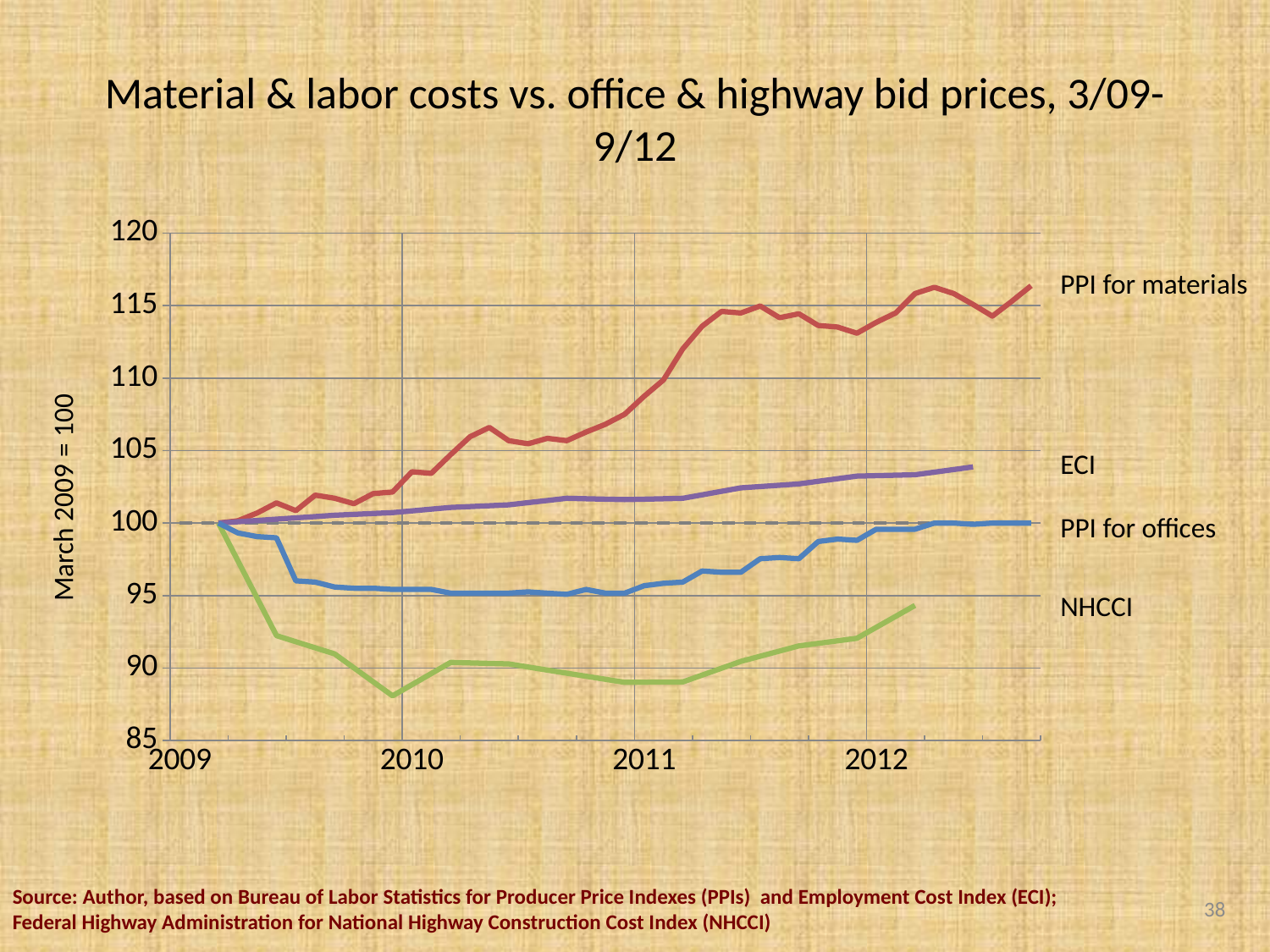
Is the lowest value of NHCCI greater or less than 90? less How many data series are plotted on the chart? 4 What is the title of the chart on the slide? Material & labor costs vs. office & highway bid prices, 3/09-9/12 What is the label on the vertical axis of the chart? March 2009 = 100 Which is larger at the start of 2012, PPI for materials or PPI for offices? PPI for materials Which series has the lowest value at the end of the period shown? NHCCI Which series has the highest value at the end of the period shown? PPI for materials Is the value of ECI at the end of the period greater or less than 105? less Is the value of PPI for materials at the end of the period greater or less than 115? greater Does the ECI series rise or fall over the period shown? rise What kind of chart is shown on the slide? line chart